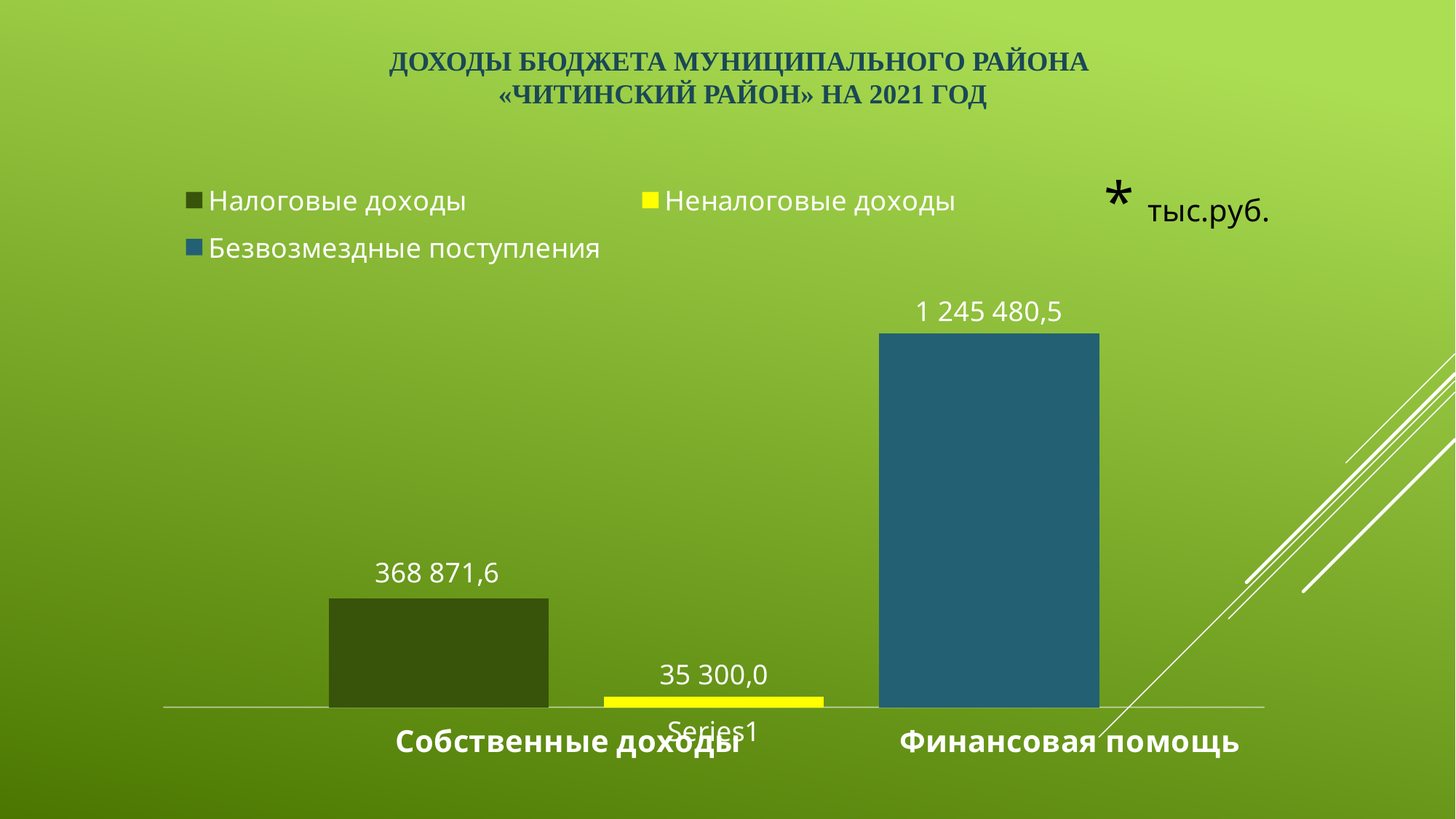
What is the value for Налоговые доходы? 368 871,6 What is the difference between Налоговые доходы and Неналоговые доходы? 333 571,6 What is the value for Безвозмездные поступления? 1 245 480,5 How many series does the legend list? 3 Which series has the lowest value? Неналоговые доходы What is the difference between Безвозмездные поступления and Налоговые доходы? 876 608,9 Which is larger, Налоговые доходы or Неналоговые доходы? Налоговые доходы What is the value for Неналоговые доходы? 35 300,0 What kind of chart is shown on the slide? Bar chart What colour is the bar for Неналоговые доходы? Yellow Which series has the highest value? Безвозмездные поступления What unit of measurement is indicated on the slide for the chart values? тыс.руб.